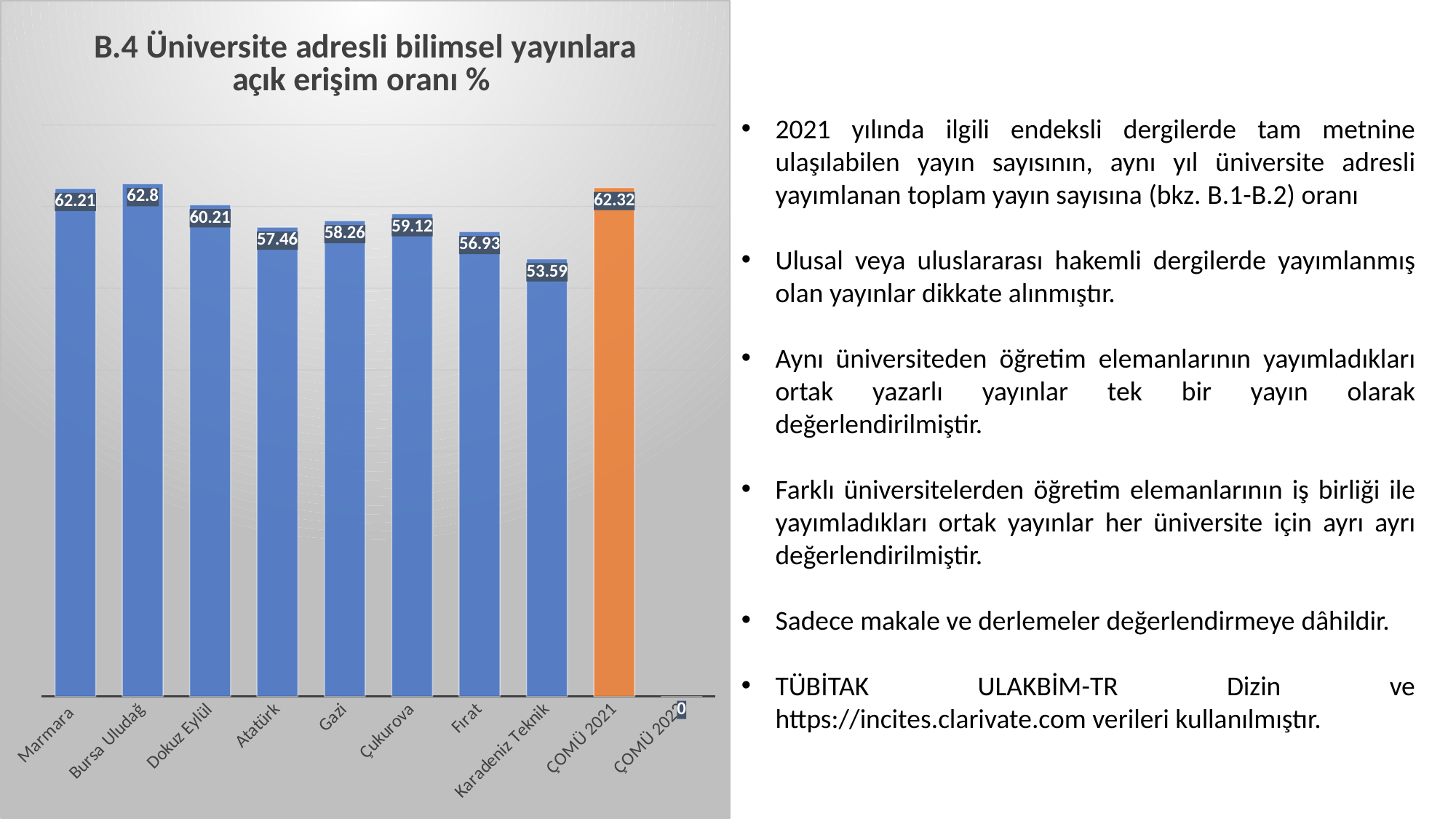
What value is shown for Atatürk? 57.46 What value is shown for ÇOMÜ 2021? 62.32 What value is shown for Bursa Uludağ? 62.8 Which bar is coloured orange instead of blue? ÇOMÜ 2021 What type of chart is shown on the slide? Bar chart How many categories are shown on the x axis? 10 What is the difference between the values for Bursa Uludağ and Karadeniz Teknik? 9.21 What is the open access rate shown for Marmara? 62.21 What value is shown for Karadeniz Teknik? 53.59 Which is larger, the value for Gazi or the value for Çukurova? Çukurova Which university has the highest value in the chart? Bursa Uludağ Which of the blue bars has the lowest value? Karadeniz Teknik